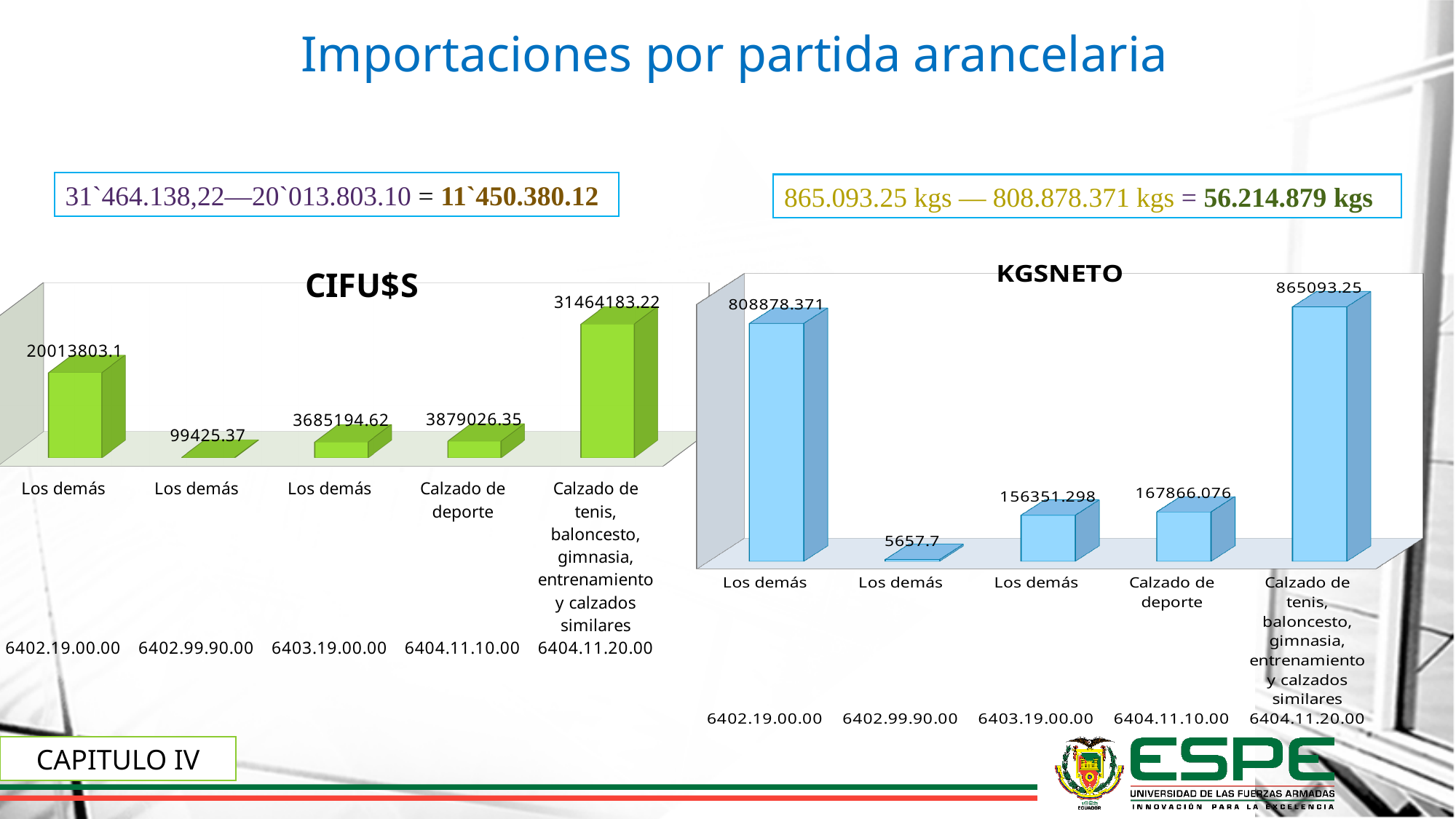
In the CIFU$S chart, what is the difference between the values for 6404.11.20.00 and 6402.19.00.00? 11450380.12 How many bars are plotted in the KGSNETO chart? 5 In the KGSNETO chart, which tariff code has the lowest value? 6402.99.90.00 In the CIFU$S chart, what is the value for tariff code 6404.11.20.00? 31464183.22 In the CIFU$S chart, what is the value for tariff code 6402.99.90.00? 99425.37 In the KGSNETO chart, what is the value for tariff code 6404.11.10.00? 167866.076 In the CIFU$S chart, which is larger: the value for 6403.19.00.00 or the value for 6404.11.10.00? 6404.11.10.00 In the KGSNETO chart, what is the difference between the values for 6404.11.20.00 and 6402.19.00.00? 56214.879 What colour are the bars in the KGSNETO chart? Blue What type of chart is the CIFU$S chart? Bar chart In the KGSNETO chart, what is the value for tariff code 6402.19.00.00? 808878.371 In the CIFU$S chart, which tariff code has the highest value? 6404.11.20.00